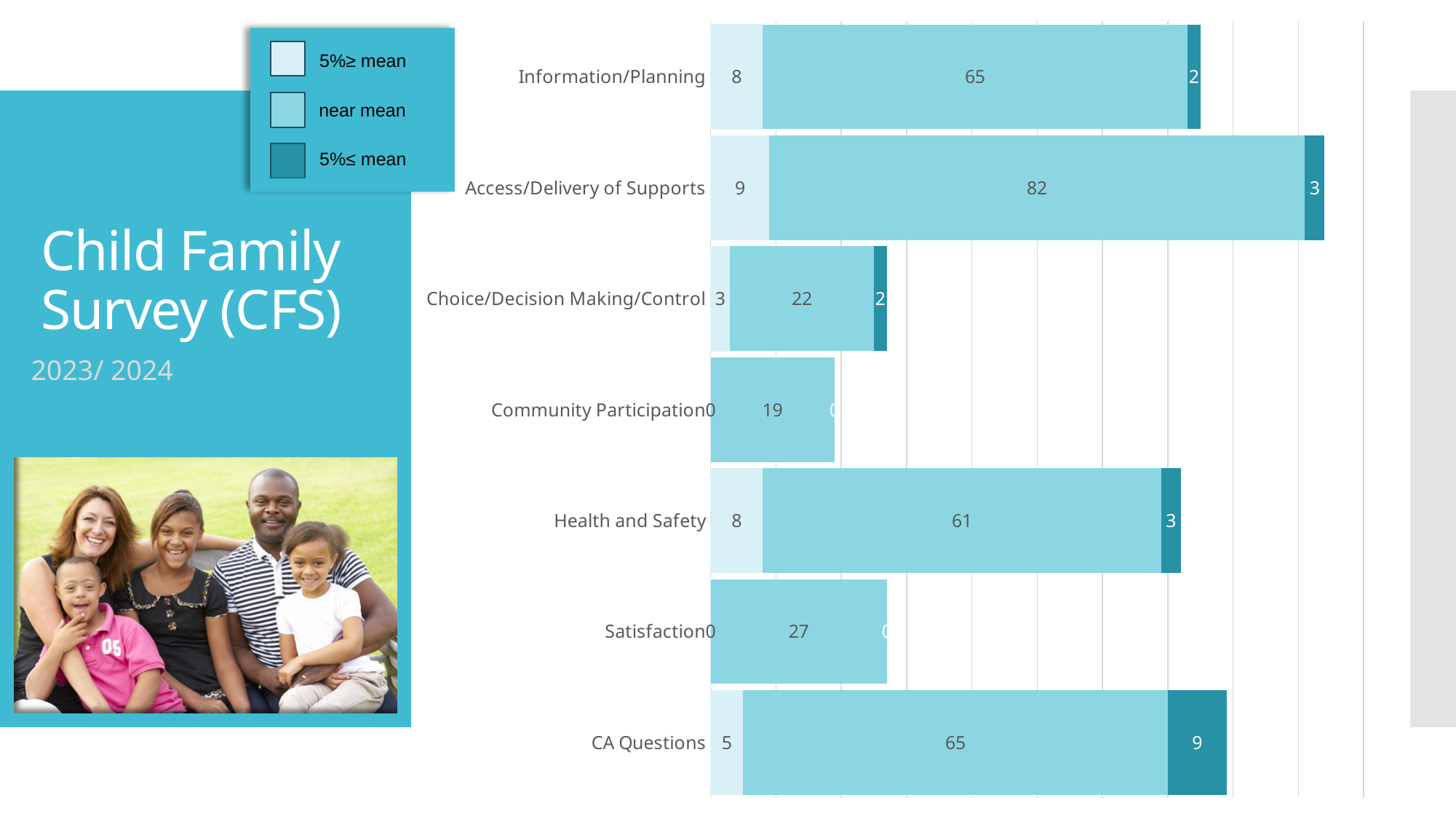
What kind of chart is shown on the slide? Stacked bar chart What is the total of the stacked bar for CA Questions? 79 How many categories are plotted in the chart? 7 What is the total of the stacked bar for Access/Delivery of Supports? 94 What is the '5%≥ mean' value for Health and Safety? 8 Which category has the highest 'near mean' value? Access/Delivery of Supports Which is larger: the 'near mean' value for Satisfaction or for Choice/Decision Making/Control? Satisfaction What is the '5%≤ mean' value for CA Questions? 9 What is the difference between the 'near mean' values for Access/Delivery of Supports and Health and Safety? 21 Which category has the lowest 'near mean' value? Community Participation How many series does the legend list? 3 What is the 'near mean' value for Access/Delivery of Supports? 82